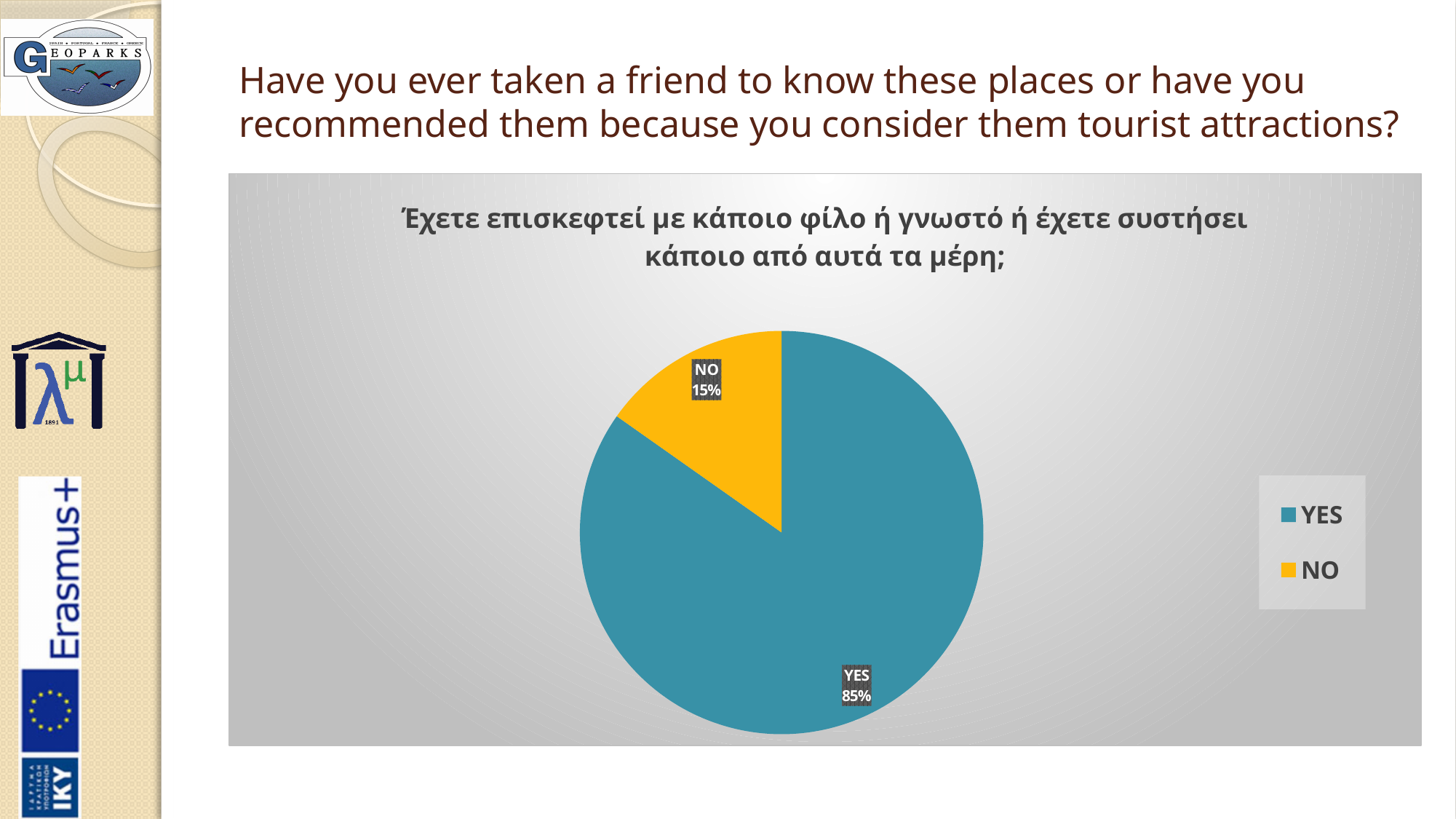
What colour is the NO slice in the pie chart? yellow What share of the pie does the NO slice represent? 15% What is the difference in percentage points between the YES and NO slices? 70 How many entries does the legend list? 2 What share of the pie does the YES slice represent? 85% What colour is the YES slice in the pie chart? teal blue Which slice is the largest in the pie chart? YES What kind of chart is shown on the slide? pie chart How many slices does the pie chart have? 2 Which slice is the smallest in the pie chart? NO Which is larger, the YES slice or the NO slice? YES